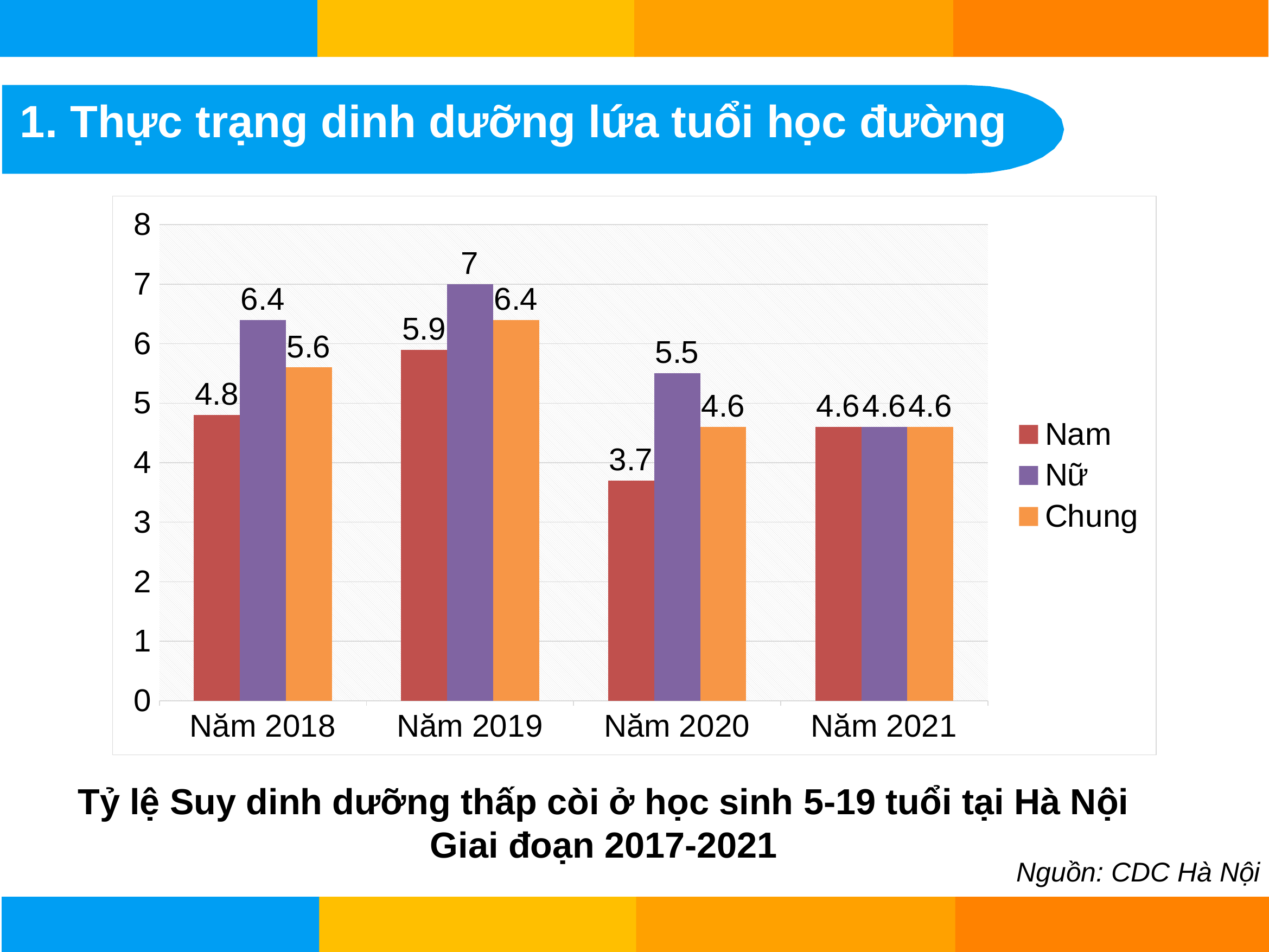
How many years are shown on the x axis? 4 What is the difference between the Nữ and Nam values in Năm 2020? 1.8 What is the value for Nữ in Năm 2019? 7 Which series is shown in purple in the legend? Nữ What kind of chart is shown on the slide? bar chart What is the value for Chung in Năm 2018? 5.6 What is the value for Nam in Năm 2020? 3.7 Which year has the lowest value for Nam? Năm 2020 How many series does the legend list? 3 Which is larger in Năm 2018, the Nam value or the Nữ value? Nữ Which year has the highest value for Nữ? Năm 2019 Is the value for Nam in Năm 2019 greater or less than 5? greater